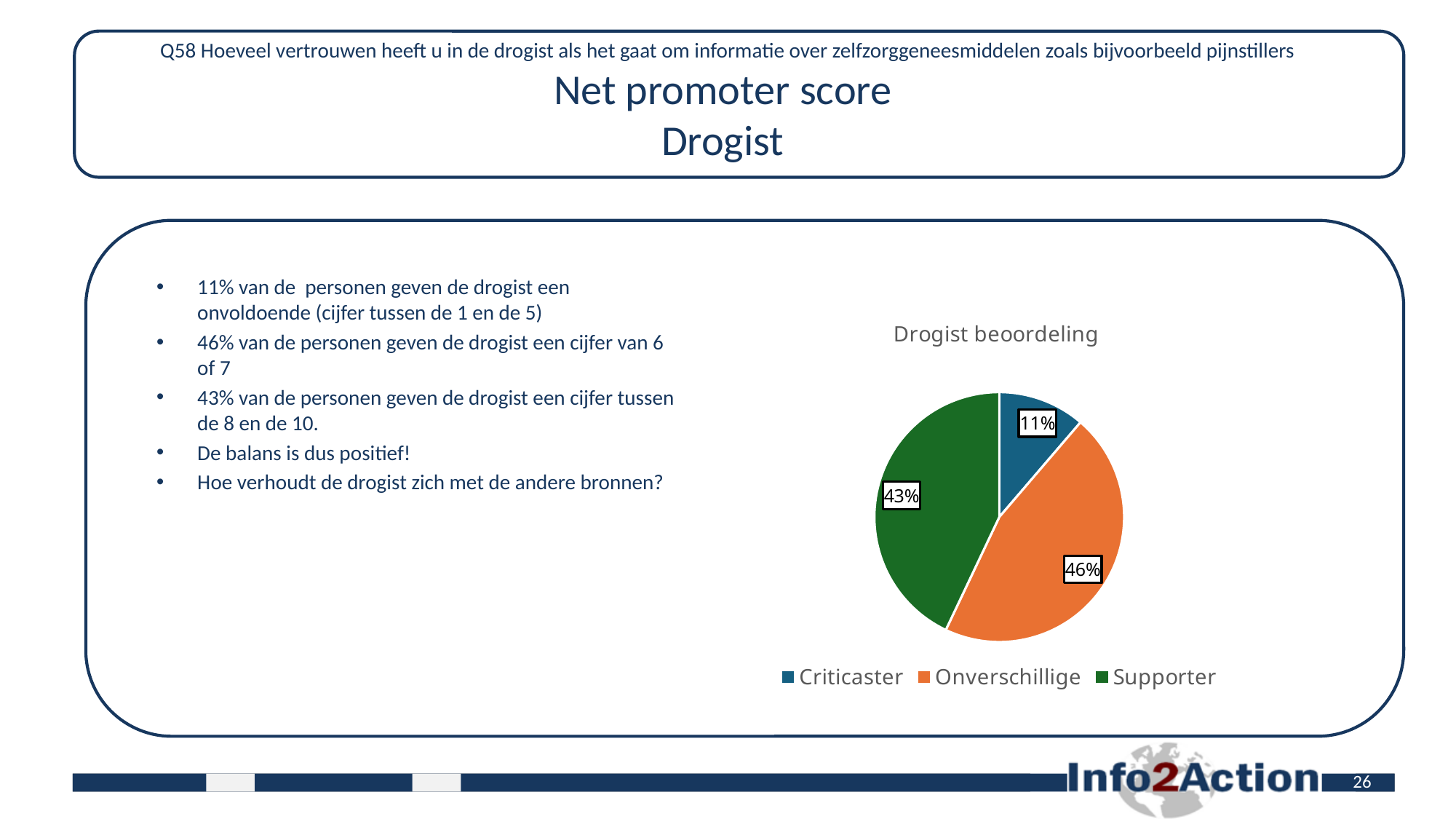
What kind of chart is shown on the slide? Pie chart What share of the pie does Criticaster represent? 11% What is the difference between the Supporter and Criticaster shares? 32% Which category has the largest slice of the pie? Onverschillige Which is larger, the Supporter share or the Criticaster share? Supporter What share of the pie does Onverschillige represent? 46% What is the difference between the Onverschillige and Supporter shares? 3% How many slices does the pie chart have? 3 What share of the pie does Supporter represent? 43% Which category has the smallest slice of the pie? Criticaster Which colour represents Supporter in the pie chart? Green What is the title of the chart? Drogist beoordeling